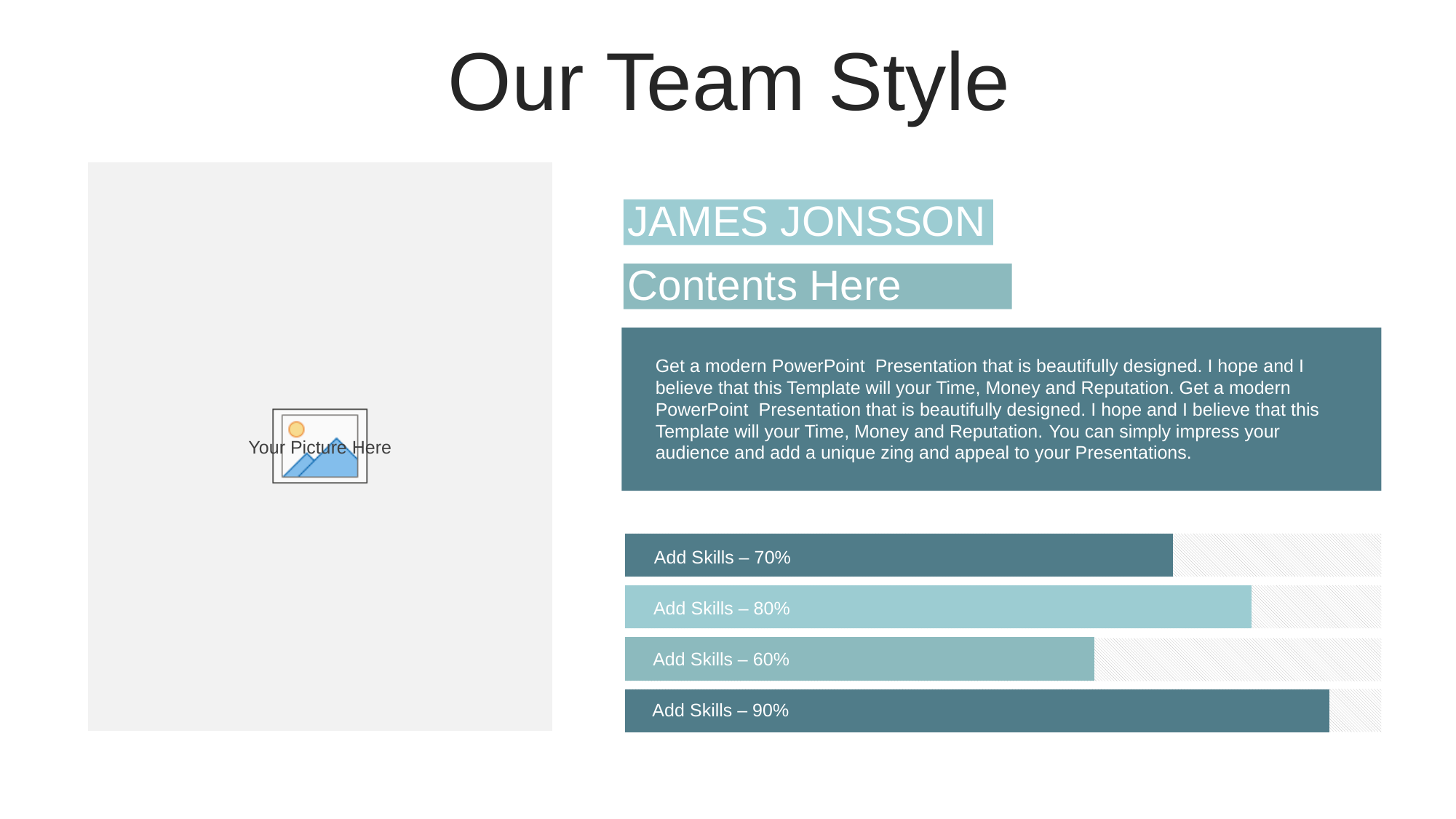
Which is larger, the value of the second bar from the top or the third bar from the top? the second bar (80%) Which skill bar has the lowest value? the third bar from the top (60%) What is the difference between the bottom bar's value and the top bar's value? 20% What value is printed on the first (top) skill bar? 70% What is the difference between the second bar's value and the third bar's value? 20% What kind of chart is shown on the slide? bar chart What value is printed on the second skill bar from the top? 80% What label text appears on each of the skill bars? Add Skills How many skill bars are shown in the chart? 4 Which skill bar has the highest value? the bottom bar (90%) What value is printed on the bottom skill bar? 90% What value is printed on the third skill bar from the top? 60%